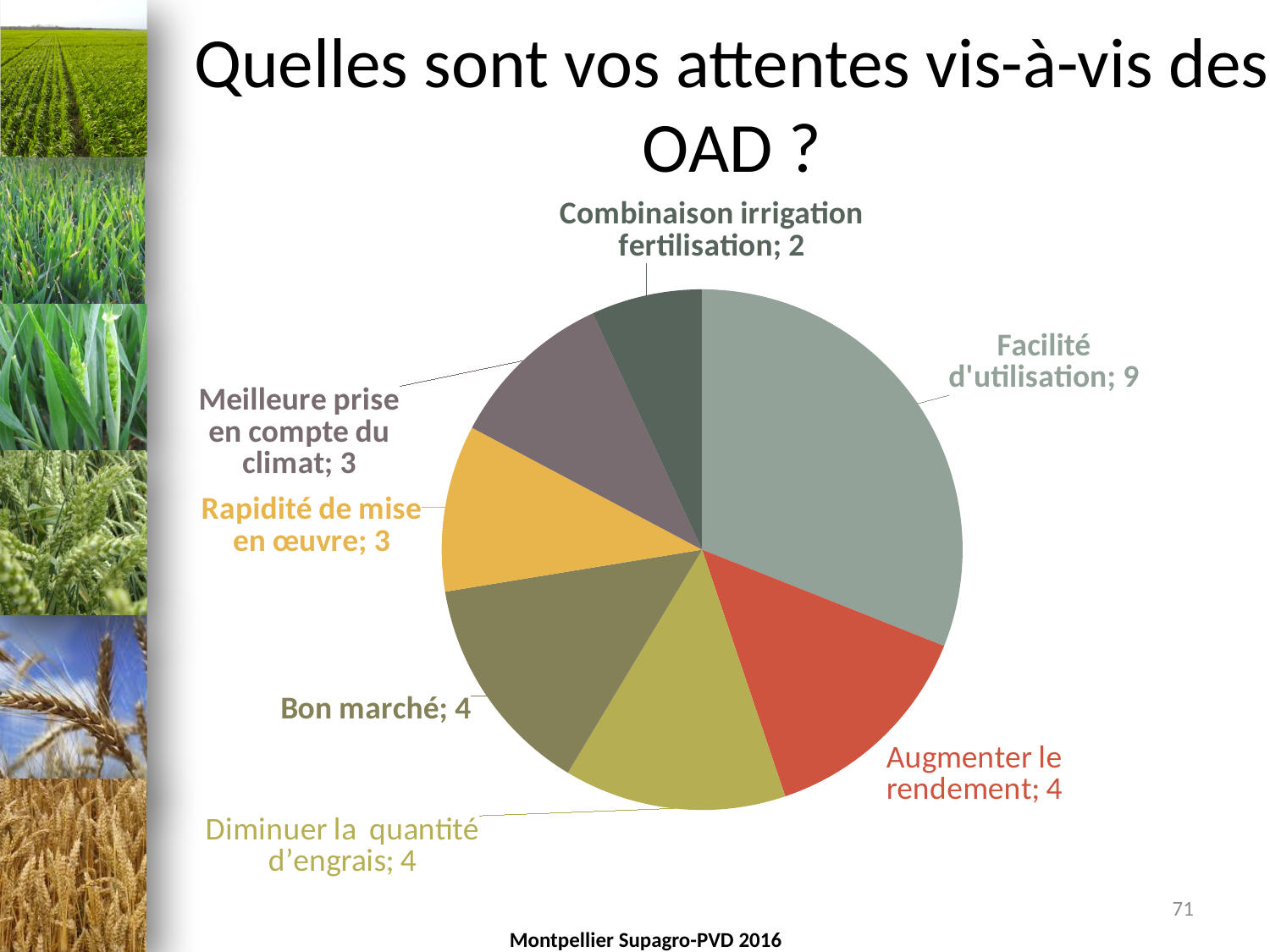
What kind of chart is shown on the slide? pie chart What is the value for "Facilité d'utilisation"? 9 Which category has the smallest slice of the pie? Combinaison irrigation fertilisation What is the value for "Bon marché"? 4 What is the value for "Combinaison irrigation fertilisation"? 2 Which category has the largest slice of the pie? Facilité d'utilisation What is the value for "Rapidité de mise en œuvre"? 3 What is the difference between the values for "Facilité d'utilisation" and "Combinaison irrigation fertilisation"? 7 Which is larger, the value for "Facilité d'utilisation" or the value for "Bon marché"? Facilité d'utilisation What is the title of the slide containing the chart? Quelles sont vos attentes vis-à-vis des OAD ? What is the difference between the values for "Augmenter le rendement" and "Meilleure prise en compte du climat"? 1 How many categories (slices) does the pie chart have? 7